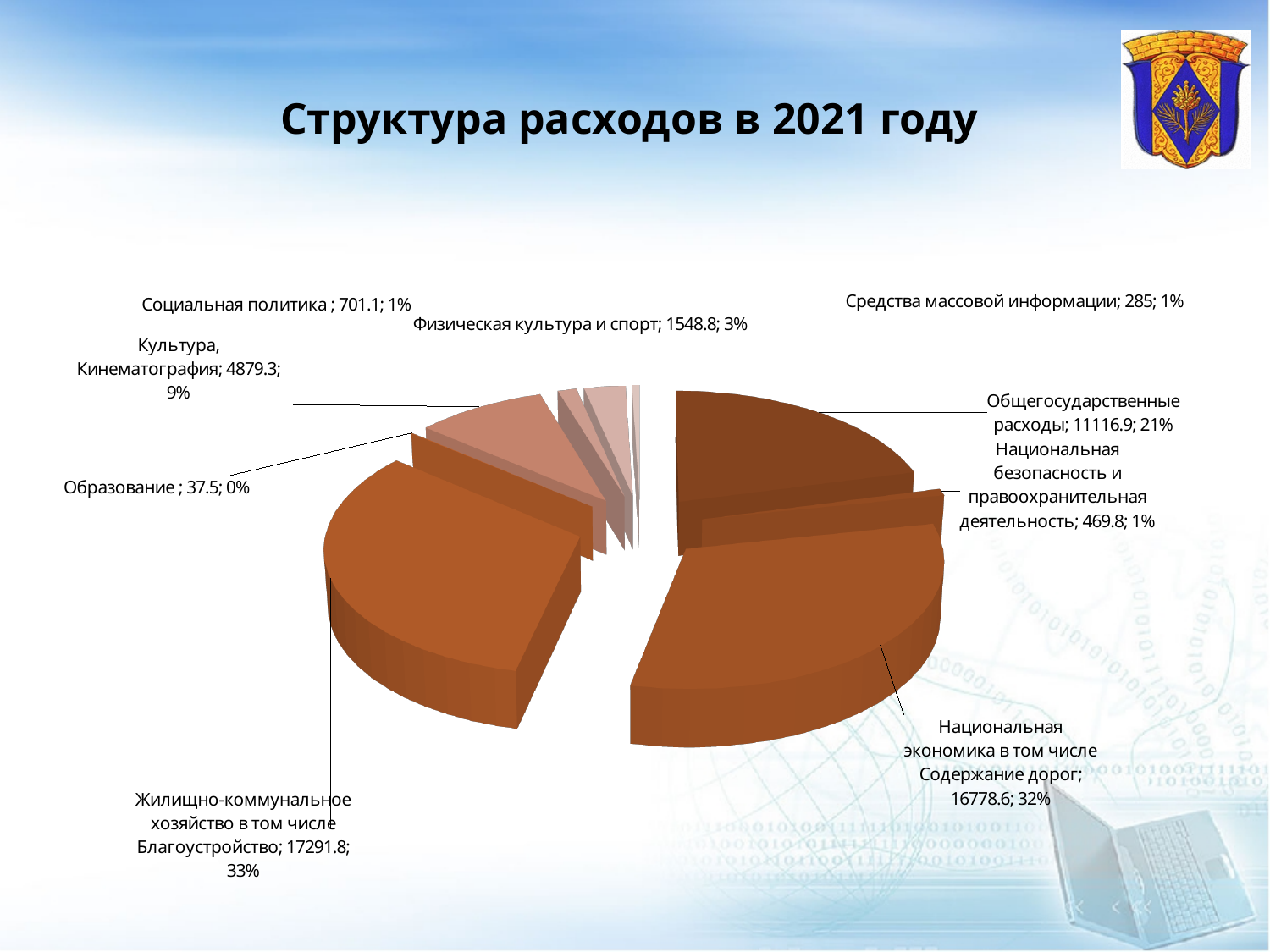
What kind of chart is shown on the slide? pie chart What is the value for Культура, Кинематография? 4879.3 What share of the pie does Национальная экономика в том числе Содержание дорог represent? 32% What is the difference between the values for Жилищно-коммунальное хозяйство and Национальная экономика? 513.2 What is the value for Общегосударственные расходы? 11116.9 Which category has the smallest value in the pie chart? Образование What share of the pie does Физическая культура и спорт represent? 3% What is the value for Средства массовой информации? 285 What is the title of the chart on the slide? Структура расходов в 2021 году How many categories (slices) does the pie chart have? 9 Which category has the largest value in the pie chart? Жилищно-коммунальное хозяйство в том числе Благоустройство Which is larger: the value for Социальная политика or the value for Национальная безопасность и правоохранительная деятельность? Социальная политика